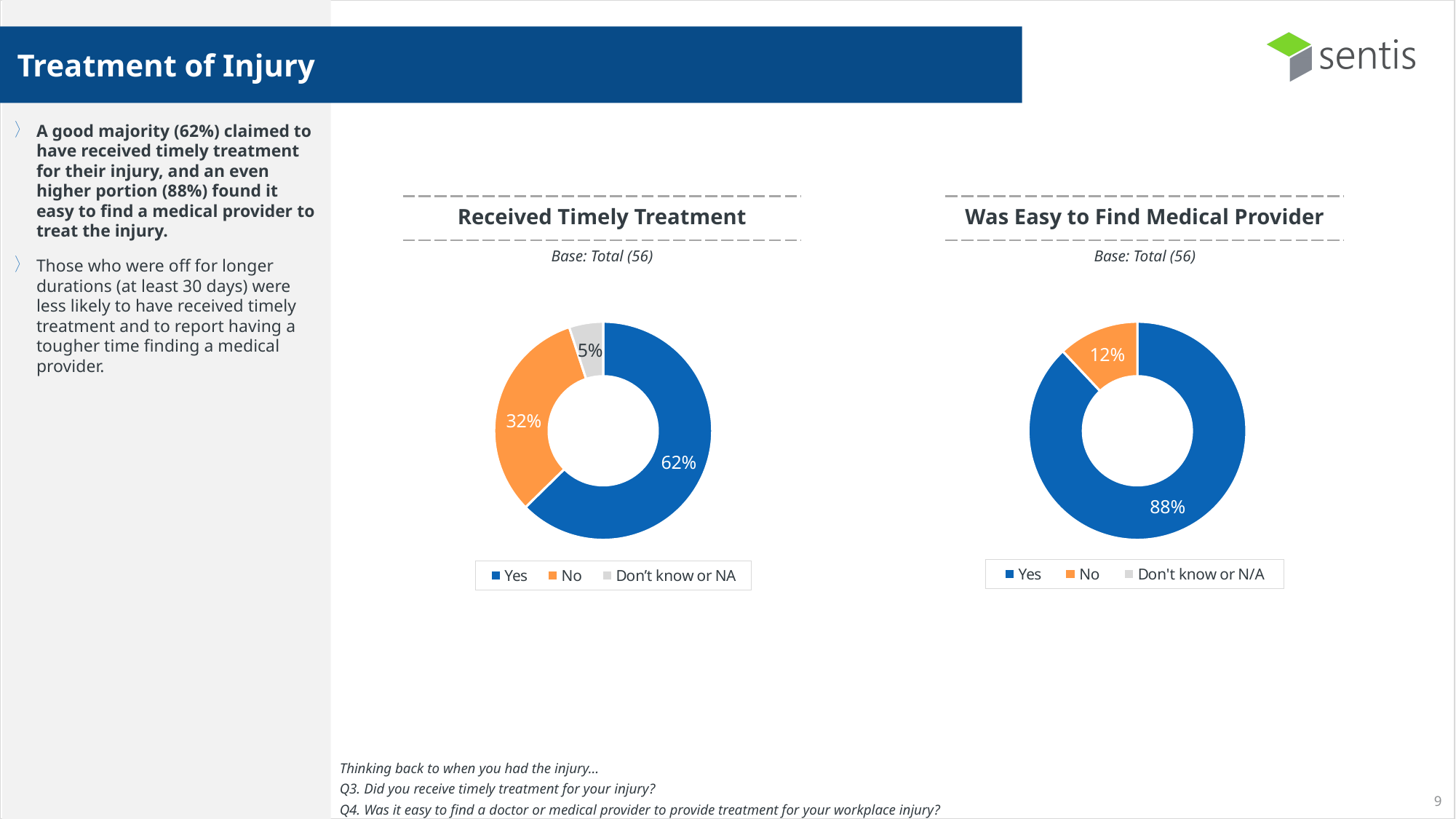
In the 'Was Easy to Find Medical Provider' chart, what percentage answered Yes? 88% What type of chart is used for 'Received Timely Treatment'? Donut (pie) chart In the 'Was Easy to Find Medical Provider' chart, what is the difference between the Yes and No shares? 76 percentage points In the 'Was Easy to Find Medical Provider' chart, what percentage answered No? 12% Which chart has the larger Yes share, 'Received Timely Treatment' or 'Was Easy to Find Medical Provider'? Was Easy to Find Medical Provider In the 'Received Timely Treatment' chart, what percentage answered No? 32% In the 'Received Timely Treatment' chart, what percentage answered Yes? 62% In the 'Received Timely Treatment' chart, what percentage is shown for 'Don't know or NA'? 5% In the 'Received Timely Treatment' chart, what is the difference between the Yes and No shares? 30 percentage points In the 'Received Timely Treatment' chart, which response has the largest share? Yes In the 'Received Timely Treatment' chart, which labelled response has the smallest share? Don't know or NA How many entries does the legend of the 'Was Easy to Find Medical Provider' chart list? 3